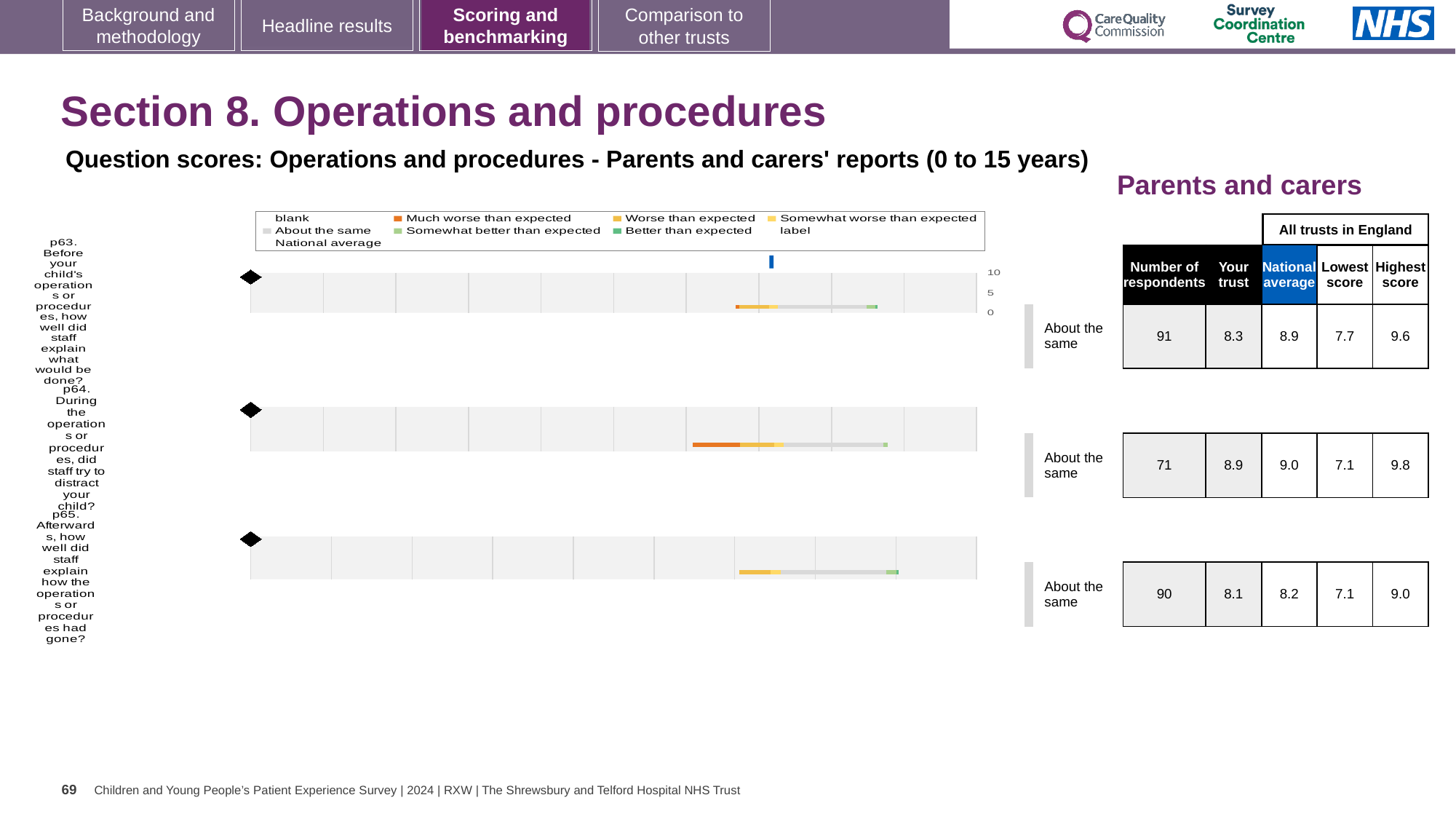
How many respondents answered p64? 71 What is the lowest score among all trusts in England for p63? 7.7 Which of the three questions has the highest 'Your trust' score? p64 What is the 'Your trust' score for p63 (Before your child's operations or procedures, how well did staff explain what would be done?)? 8.3 What is the difference between the national average and the 'Your trust' score for p63? 0.6 How many questions (p63, p64, p65) are plotted on the slide? 3 What benchmark category is shown for all three questions? About the same Is the 'Your trust' score for p65 higher or lower than the national average for p65? lower Which legend entry is shown in dark orange? Much worse than expected What is the national average score for p64 (During the operations or procedures, did staff try to distract your child?)? 9.0 What is the highest score among all trusts in England for p65 (Afterwards, how well did staff explain how the operations or procedures had gone?)? 9.0 Which of the three questions has the lowest 'Your trust' score? p65